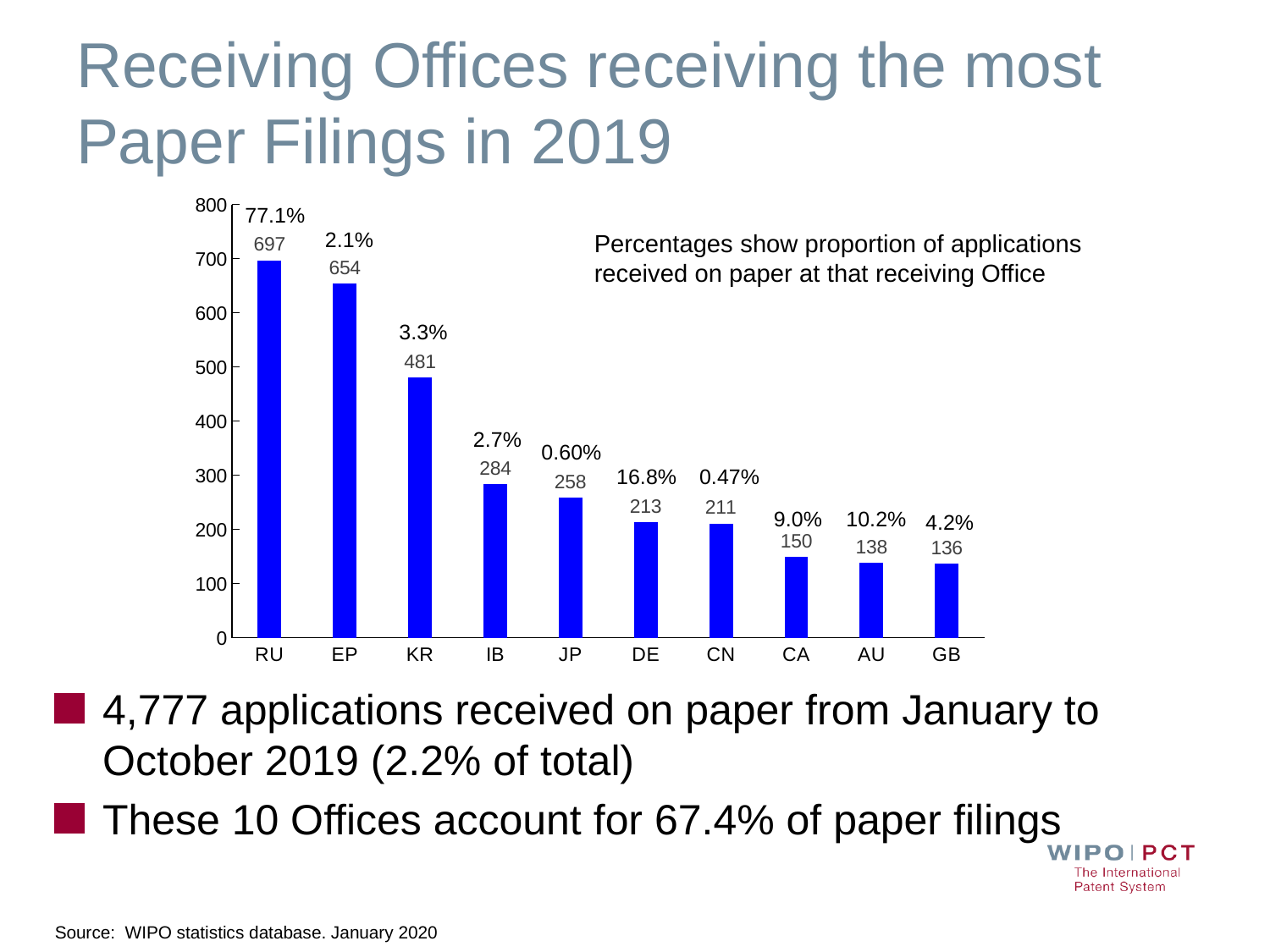
How many receiving Offices are shown on the chart? 10 Is the value for CA greater or less than 200? less Which receiving Office has the lowest number of paper filings on the chart? GB Which has more paper filings, IB or JP? IB How many paper filings did the RU receiving Office receive in 2019? 697 What percentage of applications received at DE were on paper? 16.8% What is the value shown for KR? 481 Which receiving Office has the highest number of paper filings? RU What kind of chart is shown on the slide? Bar chart Do the bar values rise or fall from left to right along the x axis? Fall What is the difference between the paper filings for RU and EP? 43 What is the title of the slide containing the chart? Receiving Offices receiving the most Paper Filings in 2019